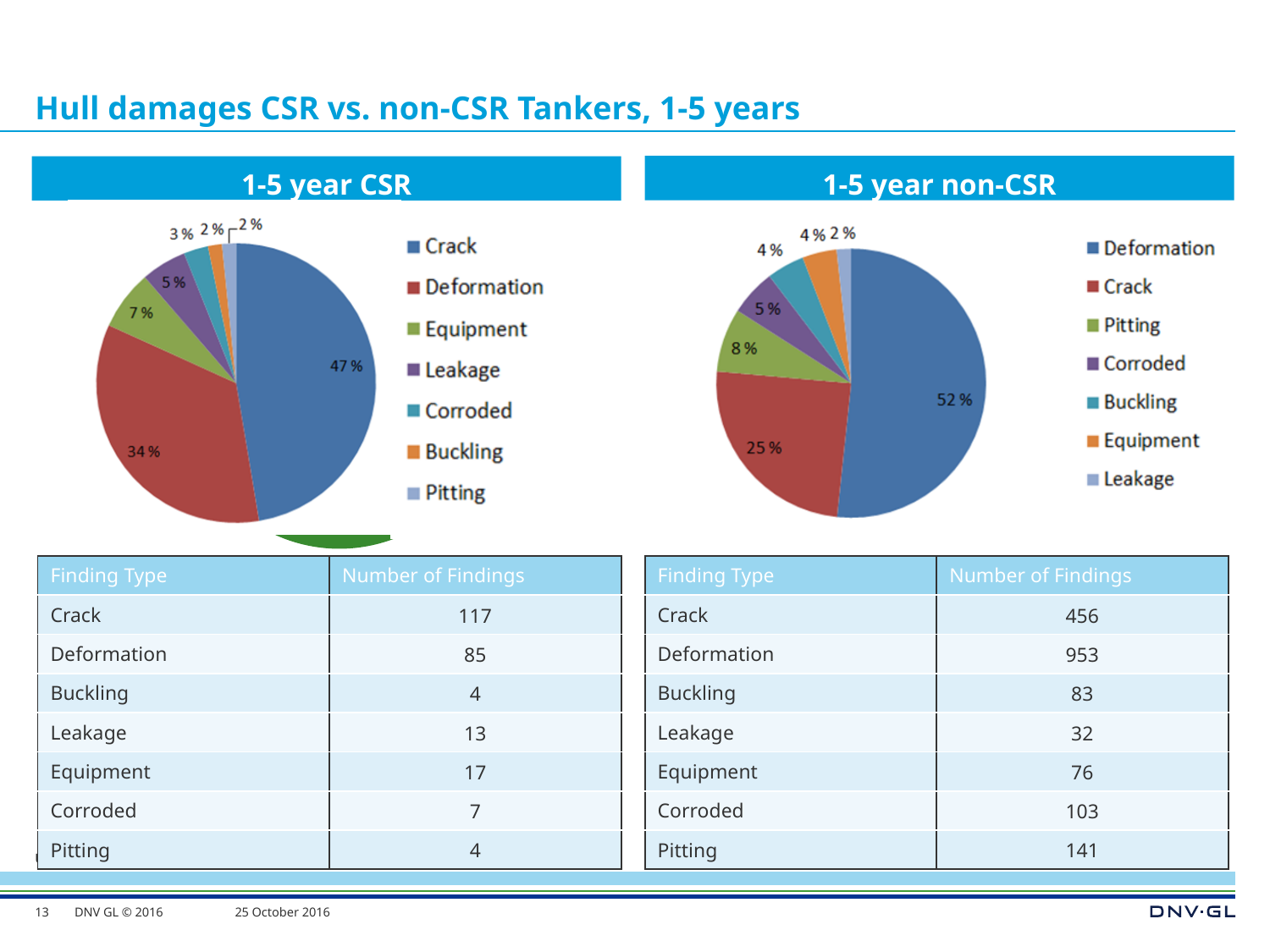
What type of chart is used for the 1-5 year CSR data? Pie chart In the 1-5 year CSR pie chart, what is the difference in percentage points between Crack and Deformation? 13 In the 1-5 year non-CSR pie chart, which finding type has the largest slice? Deformation In the 1-5 year non-CSR pie chart, which finding type has the smallest slice? Leakage In the 1-5 year CSR pie chart, what share does Crack have? 47 % In the 1-5 year non-CSR pie chart, what share does Pitting have? 8 % In the 1-5 year non-CSR pie chart, what share does Crack have? 25 % In the 1-5 year CSR pie chart, which is larger, Equipment or Leakage? Equipment How many finding types does the legend of the 1-5 year non-CSR chart list? 7 In the 1-5 year CSR pie chart, which finding type has the largest slice? Crack